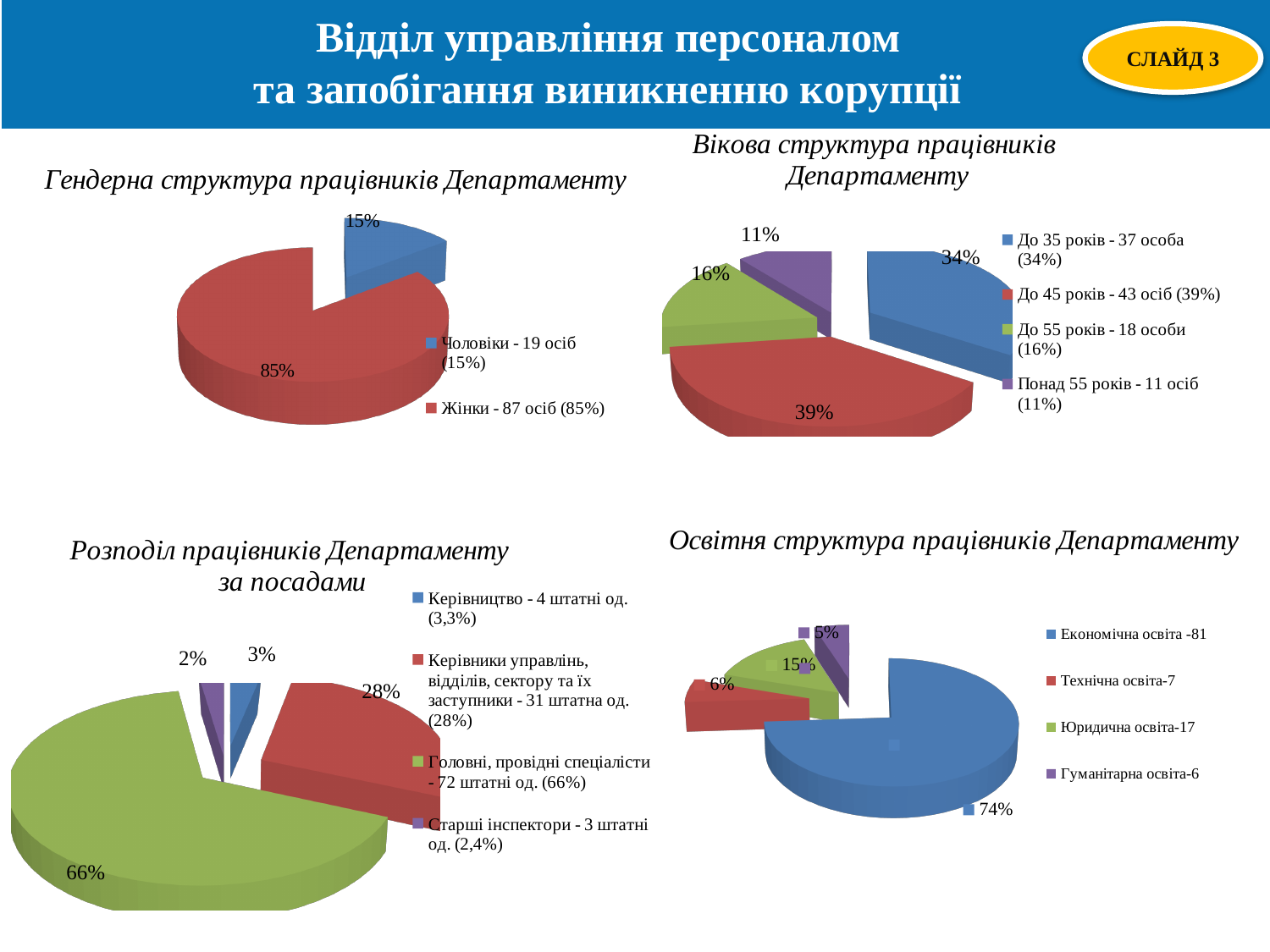
In the chart titled "Освітня структура працівників Департаменту", which education type has the largest share? Економічна освіта In the chart titled "Розподіл працівників Департаменту за посадами", how many штатні од. does the legend give for Керівники управлінь, відділів, сектору та їх заступники? 31 штатна од. In the chart titled "Освітня структура працівників Департаменту", which is larger: Технічна освіта or Гуманітарна освіта? Технічна освіта In the chart titled "Вікова структура працівників Департаменту", which age group has the smallest share? Понад 55 років In the chart titled "Вікова структура працівників Департаменту", which age group has the largest share? До 45 років What kind of chart is "Вікова структура працівників Департаменту"? Pie chart In the chart titled "Гендерна структура працівників Департаменту", what share of the pie is labelled for Жінки? 85% In the chart titled "Освітня структура працівників Департаменту", what share of the pie is labelled for Юридична освіта? 15% In the chart titled "Гендерна структура працівників Департаменту", how many people does the legend give for Чоловіки? 19 осіб In the chart titled "Розподіл працівників Департаменту за посадами", what share of the pie is labelled for Головні, провідні спеціалісти? 66% In the chart titled "Вікова структура працівників Департаменту", how many series does the legend list? 4 In the chart titled "Вікова структура працівників Департаменту", what is the difference in number of people between До 45 років and До 35 років? 6